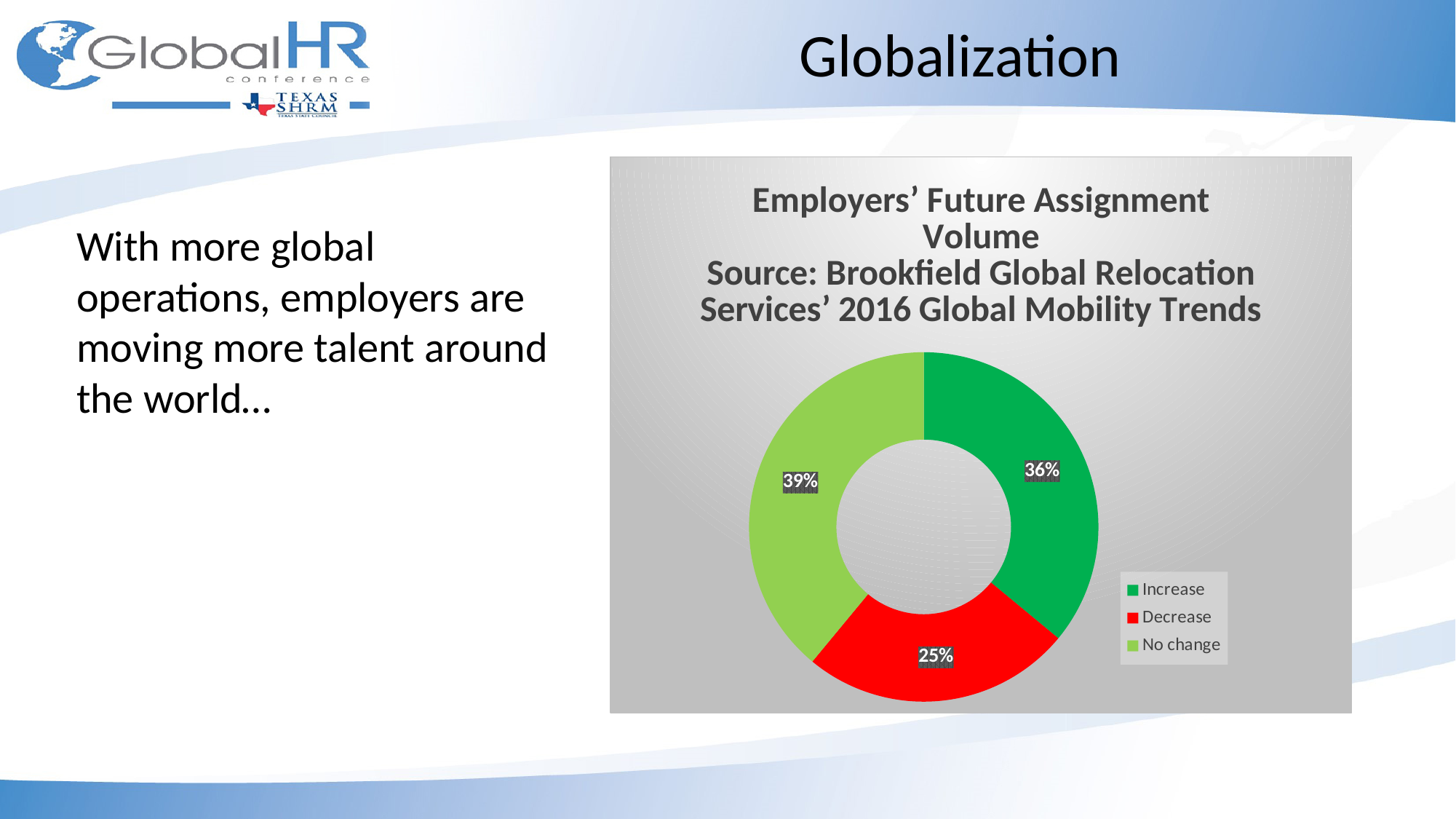
What percentage of employers expect their future assignment volume to decrease? 25% What percentage of employers expect their future assignment volume to increase? 36% What is the difference in percentage points between the 'No change' and 'Decrease' shares? 14 What is the title of the chart? Employers' Future Assignment Volume How many categories does the chart show? 3 Which category has the smallest share of the chart? Decrease What colour represents the 'Decrease' category in the chart? Red Which category has the largest share of the chart? No change What is the difference in percentage points between the 'Increase' and 'Decrease' shares? 11 What percentage of employers expect no change in future assignment volume? 39% Which is larger, the share for 'Increase' or the share for 'Decrease'? Increase What kind of chart is shown on the slide? Doughnut (pie) chart